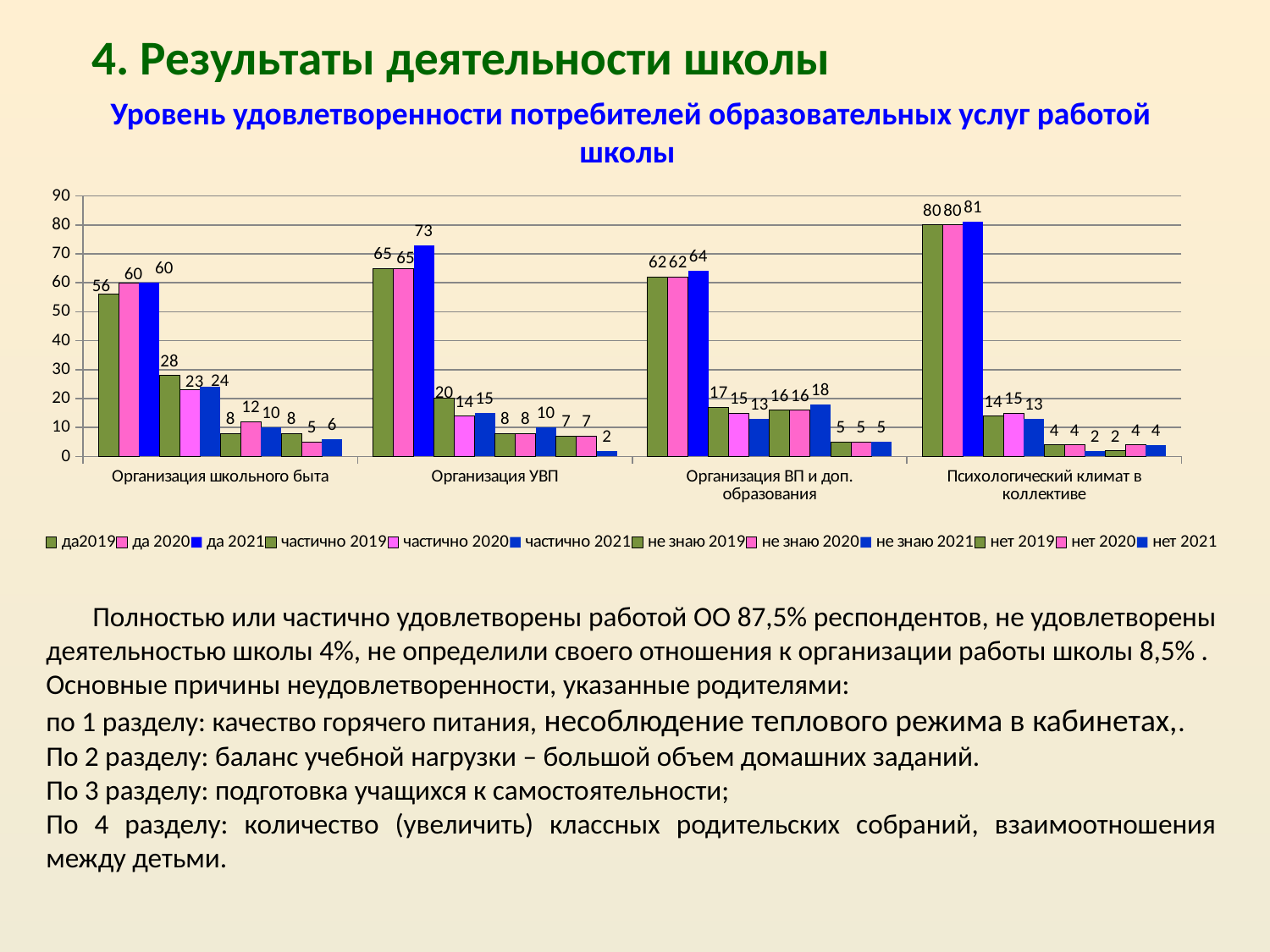
What is the value for "да2019" in the category "Организация школьного быта"? 56 What is the title of the chart on the slide? Уровень удовлетворенности потребителей образовательных услуг работой школы What is the value for "не знаю 2021" in the category "Организация ВП и доп. образования"? 18 What is the value for "частично 2019" in the category "Организация школьного быта"? 28 How many categories are shown on the x axis of the chart? 4 How many series does the chart legend list? 12 What is the value for "да 2021" in the category "Организация УВП"? 73 Which category has the highest value for "да 2021"? Психологический климат в коллективе Which is larger in the category "Организация УВП": the value for "частично 2019" or the value for "частично 2020"? частично 2019 What type of chart is shown on the slide? bar chart Which category has the lowest value for "да2019"? Организация школьного быта What is the difference between the "да 2021" value and the "да2019" value in the category "Организация школьного быта"? 4